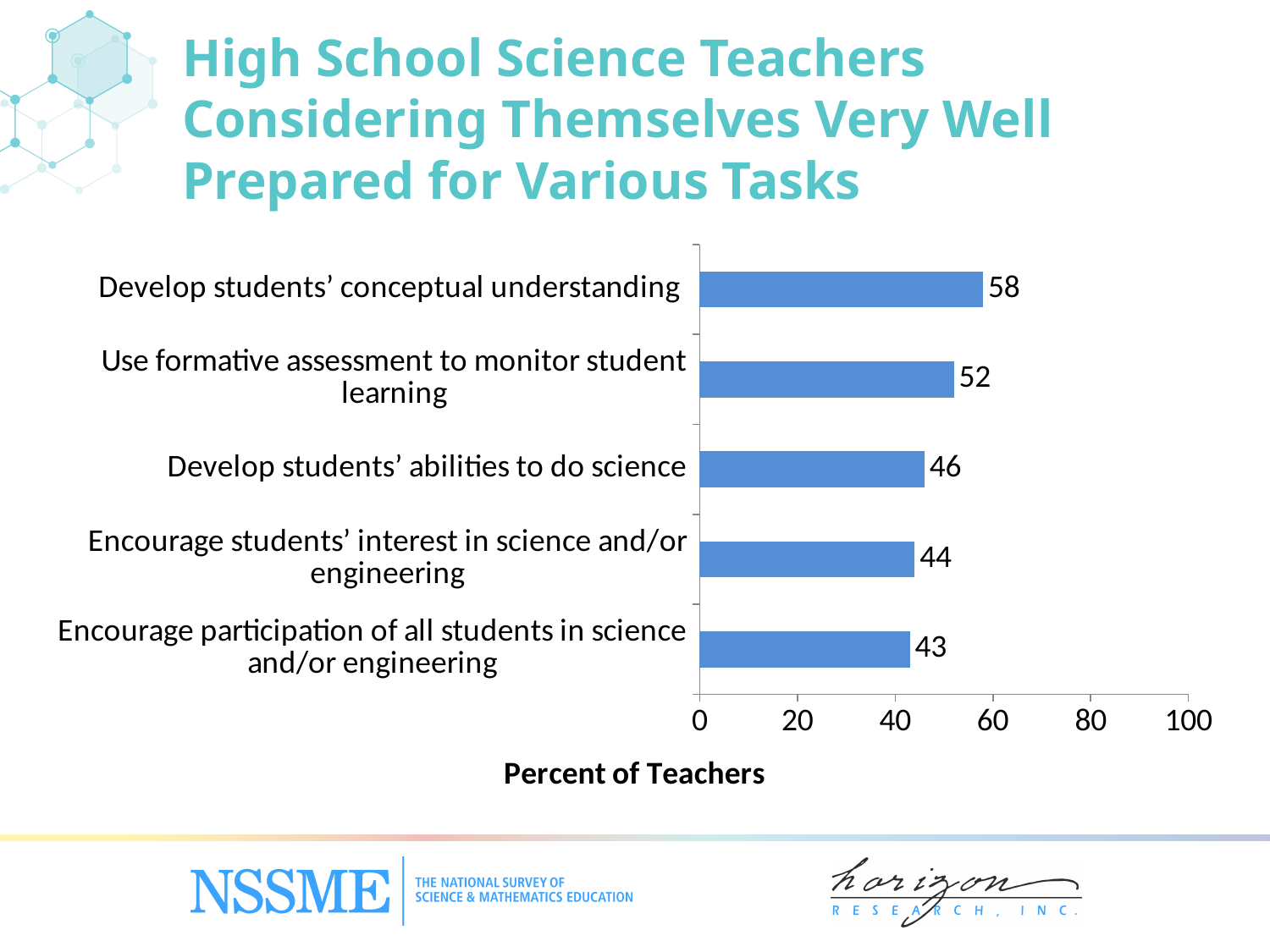
How many tasks are shown in the chart? 5 Which task has the highest percent of teachers considering themselves very well prepared? Develop students' conceptual understanding What is the difference between the values for 'Develop students' conceptual understanding' and 'Develop students' abilities to do science'? 12 What is the value for 'Use formative assessment to monitor student learning'? 52 Which is larger: the value for 'Use formative assessment to monitor student learning' or the value for 'Encourage students' interest in science and/or engineering'? Use formative assessment to monitor student learning Is the value for 'Develop students' abilities to do science' greater or less than 60? less What percent of high school science teachers consider themselves very well prepared to develop students' conceptual understanding? 58 What kind of chart is shown on the slide? bar chart Which task has the lowest percent of teachers considering themselves very well prepared? Encourage participation of all students in science and/or engineering What is the maximum value shown on the horizontal axis? 100 What is the label of the horizontal axis? Percent of Teachers What is the value for 'Encourage participation of all students in science and/or engineering'? 43